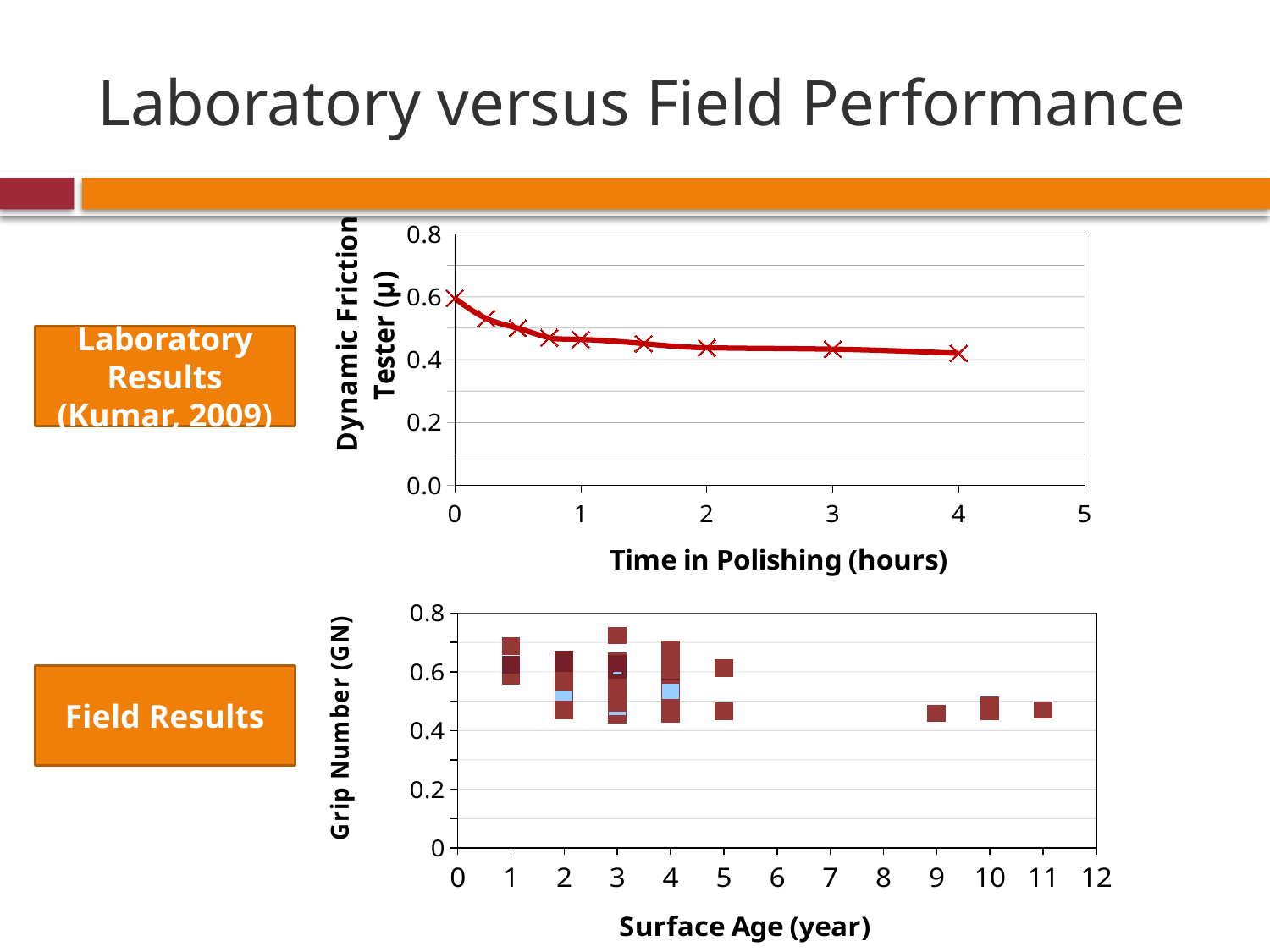
In the bottom chart (Grip Number vs Surface Age), do the grip numbers generally rise or fall as surface age increases? fall In the bottom chart (Grip Number vs Surface Age), are the values at a surface age of 9 years greater or less than 0.6? less In the bottom chart (Grip Number vs Surface Age), what is the label of the y axis? Grip Number (GN) In the top chart (Dynamic Friction Tester vs Time in Polishing), what kind of chart is it? line chart In the bottom chart (Grip Number vs Surface Age), are the values at a surface age of 1 year greater or less than 0.4? greater In the top chart (Dynamic Friction Tester vs Time in Polishing), is the value at 0 hours greater or less than 0.4? greater In the top chart (Dynamic Friction Tester vs Time in Polishing), which time in polishing has the highest value? 0 hours In the top chart (Dynamic Friction Tester vs Time in Polishing), what is the label of the x axis? Time in Polishing (hours) In the bottom chart (Grip Number vs Surface Age), how many surface ages have data plotted? 8 In the top chart (Dynamic Friction Tester vs Time in Polishing), do the values rise or fall as time in polishing increases? fall In the top chart (Dynamic Friction Tester vs Time in Polishing), how many data points are plotted? 9